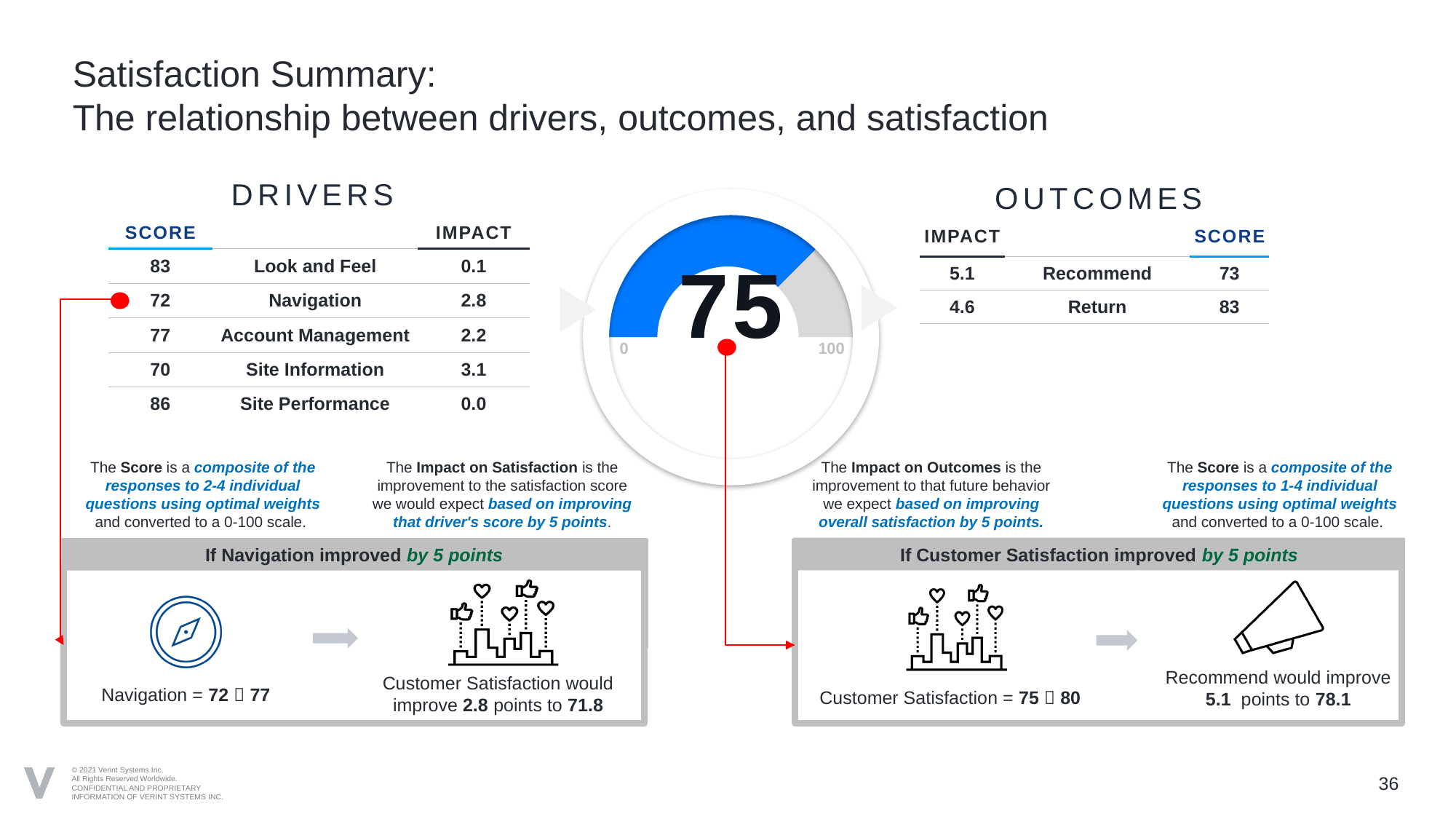
What value does the central gauge chart display? 75 In the Outcomes table, what is the score for Return? 83 In the Drivers table, what is the score for Navigation? 72 In the Outcomes table, what is the impact for Recommend? 5.1 What kind of chart is shown in the centre of the slide? gauge chart How many drivers are listed in the Drivers table? 5 In the Drivers table, which driver has the highest impact? Site Information Is the value shown on the gauge chart greater or less than 50? greater What are the minimum and maximum values marked on the gauge chart's scale? 0 and 100 In the Drivers table, which driver has the highest score? Site Performance In the Drivers table, which driver has the lowest score? Site Information In the Drivers table, what is the difference between the scores for Site Performance and Site Information? 16